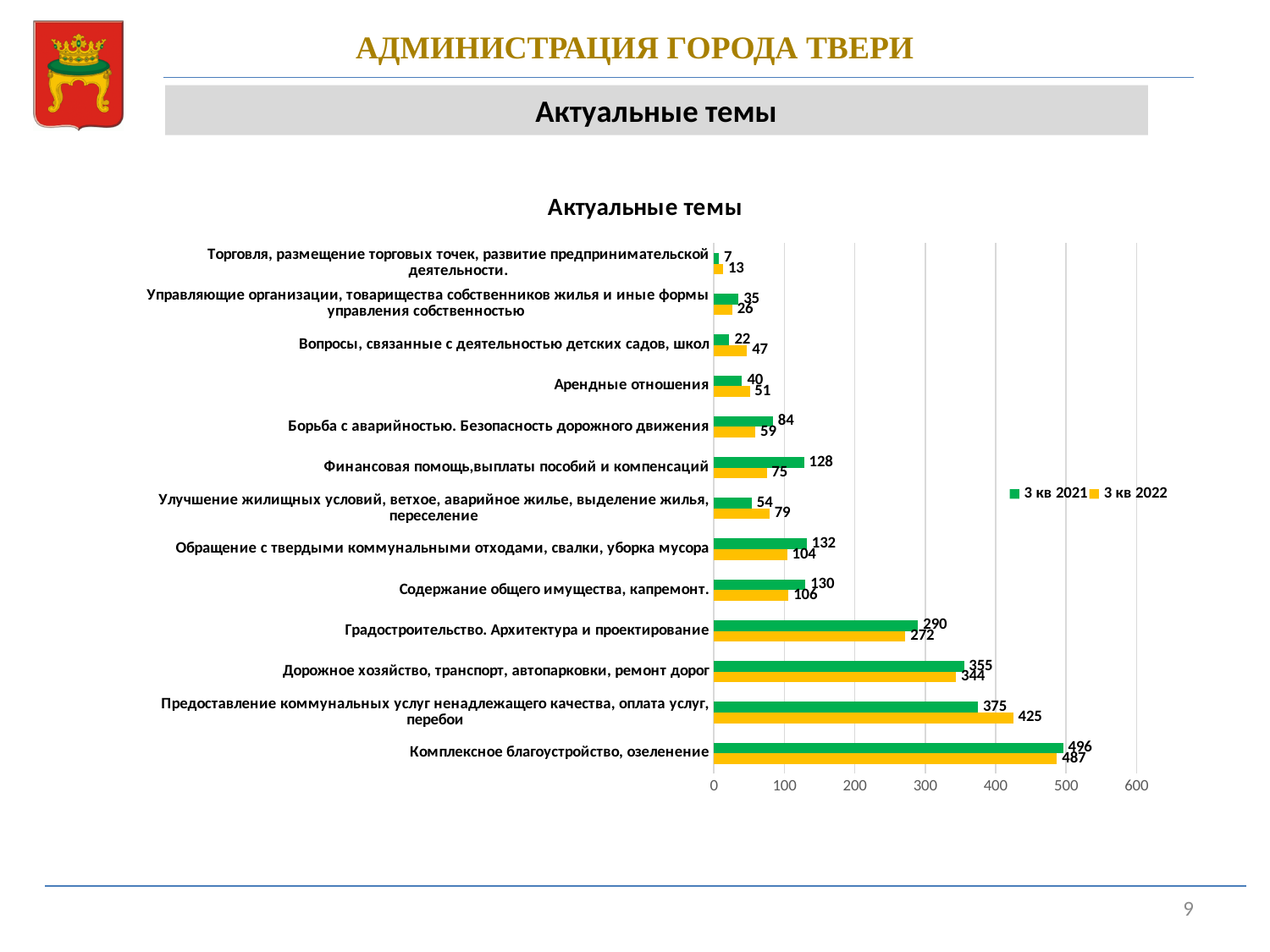
Which category has the lowest value in the «3 кв 2021» series? Торговля, размещение торговых точек, развитие предпринимательской деятельности. Which category has the highest value in the «3 кв 2022» series? Комплексное благоустройство, озеленение What is the value for «Арендные отношения» in the «3 кв 2022» series? 51 For «Финансовая помощь,выплаты пособий и компенсаций», which series has the larger value: «3 кв 2021» or «3 кв 2022»? 3 кв 2021 What is the value for «Комплексное благоустройство, озеленение» in the «3 кв 2021» series? 496 What type of chart is shown on the slide? bar chart What is the value for «Предоставление коммунальных услуг ненадлежащего качества, оплата услуг, перебои» in the «3 кв 2022» series? 425 What is the difference between the «3 кв 2022» and «3 кв 2021» values for «Предоставление коммунальных услуг ненадлежащего качества, оплата услуг, перебои»? 50 Is the «3 кв 2021» value for «Градостроительство. Архитектура и проектирование» greater or less than 200? greater How many series does the legend list? 2 How many categories are shown on the chart? 13 What is the title of the chart? Актуальные темы